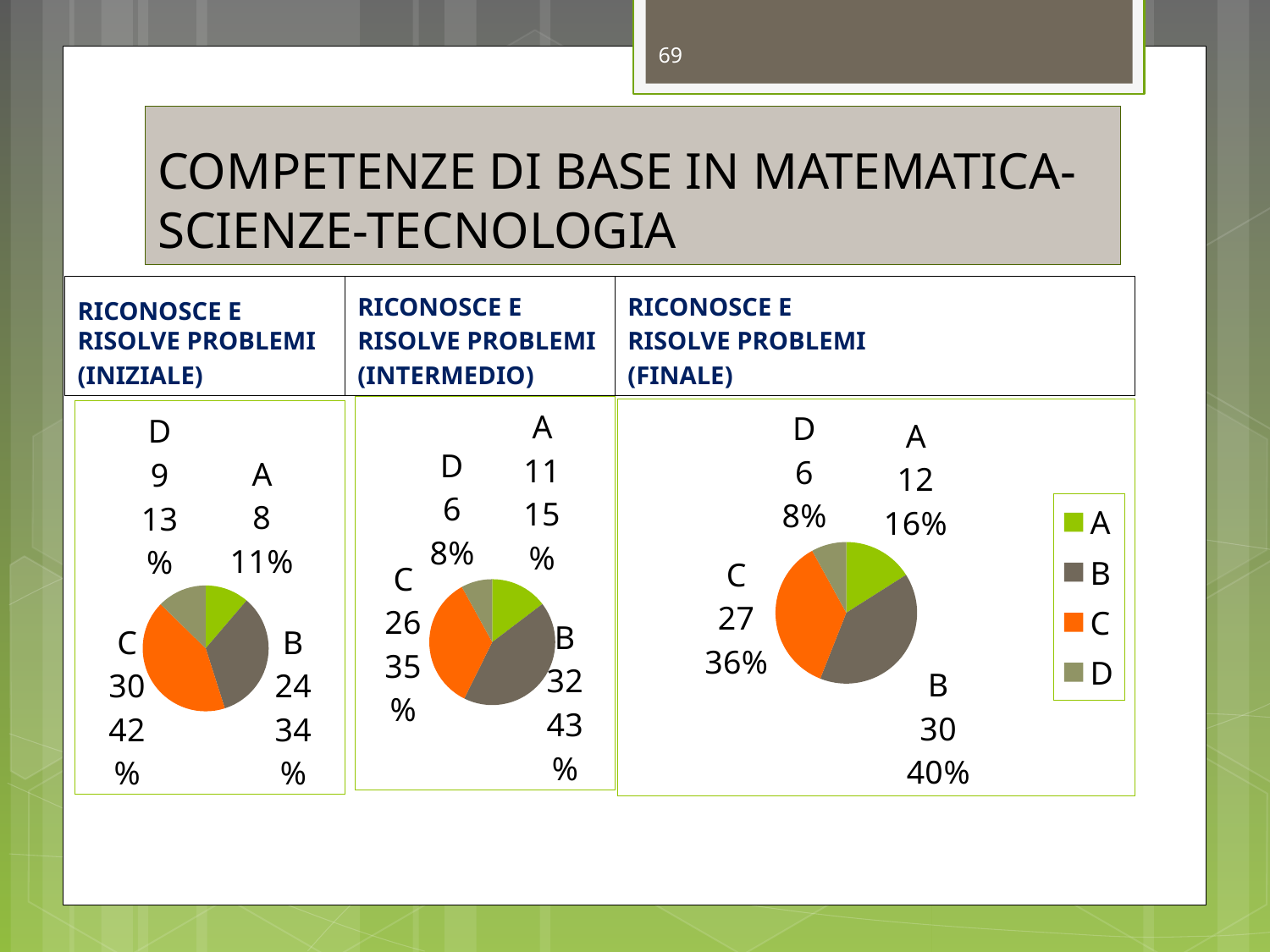
What type of chart is used for the INIZIALE data? Pie chart In the INIZIALE pie chart, which category has the largest share? C How many categories does the legend of the FINALE chart list? 4 In the INIZIALE pie chart, what percentage is shown for category C? 42% In the FINALE pie chart, what colour represents category C? Orange In the FINALE pie chart, which is larger, the count for category C or the count for category B? B In the FINALE pie chart, which category has the largest share? B In the INTERMEDIO pie chart, what percentage is shown for category B? 43% In the INTERMEDIO pie chart, what is the difference in count between category B and category C? 6 In the INTERMEDIO pie chart, which category has the smallest share? D In the FINALE pie chart, what percentage is shown for category A? 16% In the INIZIALE pie chart, what count is shown for category B? 24